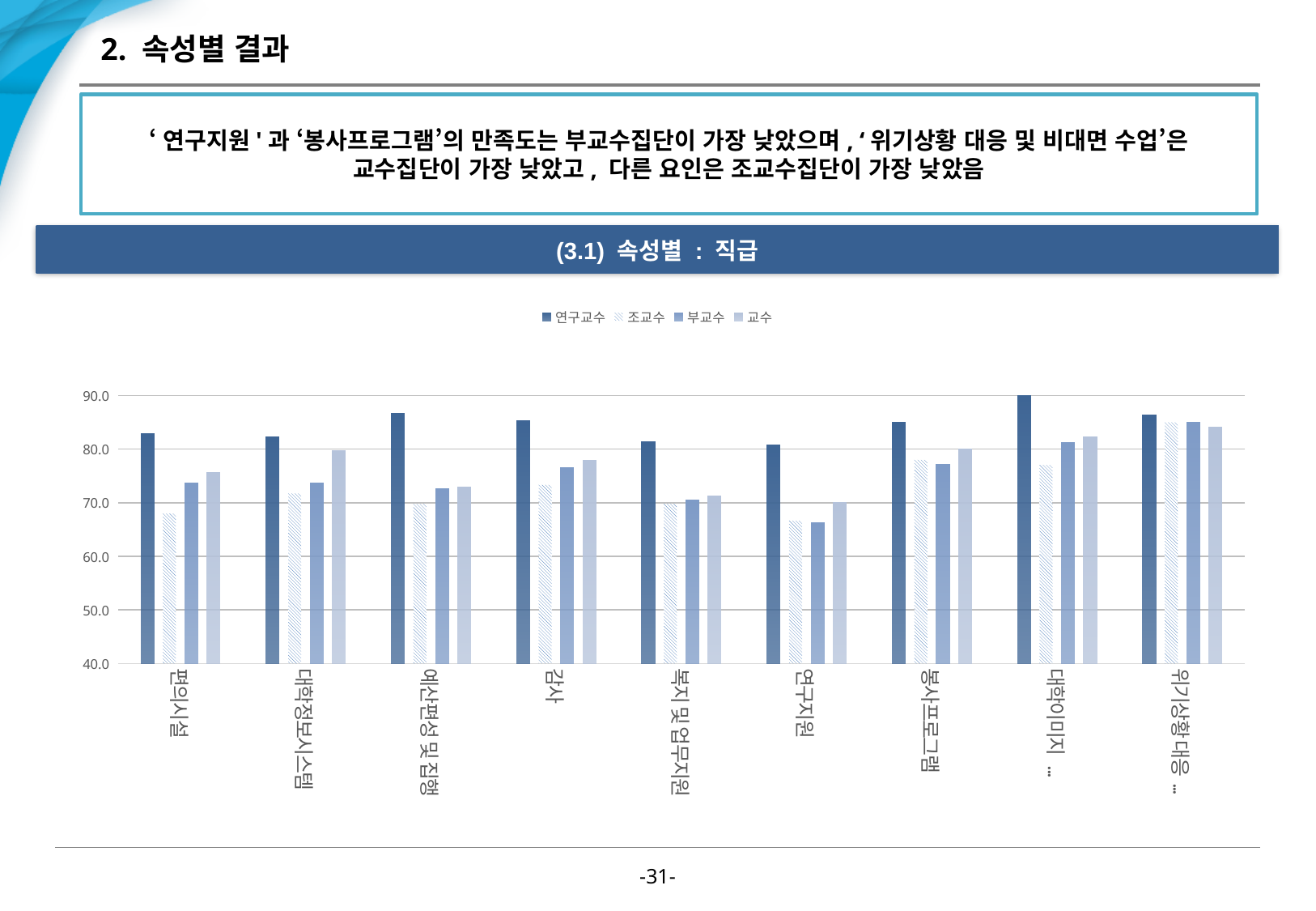
For 편의시설, which series has the highest value? 연구교수 Is the 조교수 value for 편의시설 greater or less than 70? less Is the 부교수 value for 연구지원 greater or less than 70? less Is the 연구교수 value for 편의시설 greater or less than 80? greater What kind of chart is shown on the slide? bar chart Which category has the lowest 부교수 value? 연구지원 How many categories are shown on the x axis? 9 Which category has the highest 연구교수 value? 대학이미지 Which series is listed first in the legend? 연구교수 How many series does the legend list? 4 Which is larger for 교수: the value for 편의시설 or for 대학정보시스템? 대학정보시스템